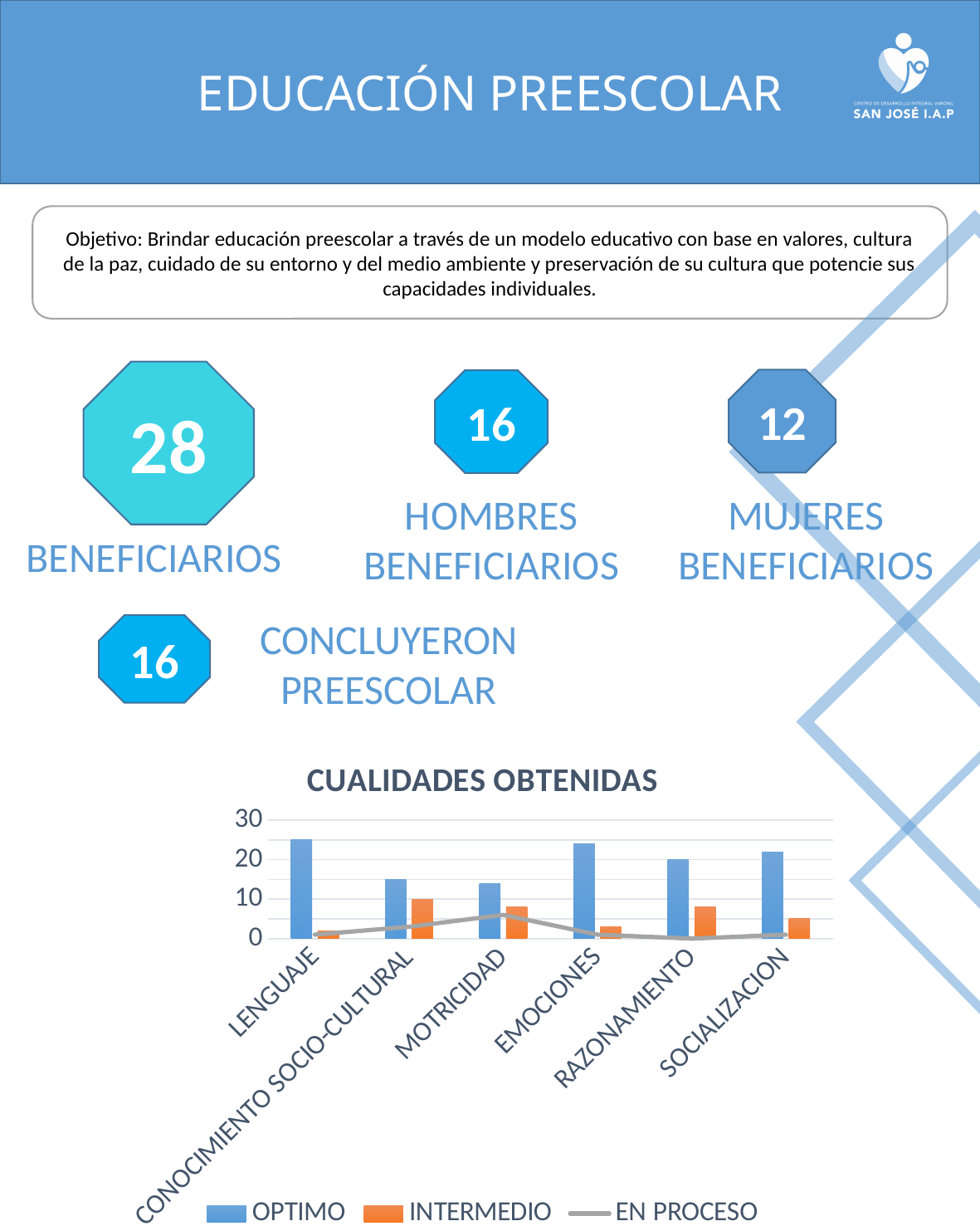
How many categories are shown on the x axis of the CUALIDADES OBTENIDAS chart? 6 Which has the larger OPTIMO value: LENGUAJE or CONOCIMIENTO SOCIO-CULTURAL? LENGUAJE What kind of chart is shown under the title CUALIDADES OBTENIDAS? combination bar and line chart For LENGUAJE, which is larger: the OPTIMO value or the INTERMEDIO value? OPTIMO Is the OPTIMO value for EMOCIONES greater or less than 20? greater What is the title of the chart on the slide? CUALIDADES OBTENIDAS Which series in the CUALIDADES OBTENIDAS chart is drawn as a line rather than bars? EN PROCESO Is the OPTIMO value for MOTRICIDAD greater or less than 10? greater How many series does the legend of the CUALIDADES OBTENIDAS chart list? 3 Is the INTERMEDIO value for LENGUAJE greater or less than 10? less Which category has the lowest INTERMEDIO value in the CUALIDADES OBTENIDAS chart? LENGUAJE